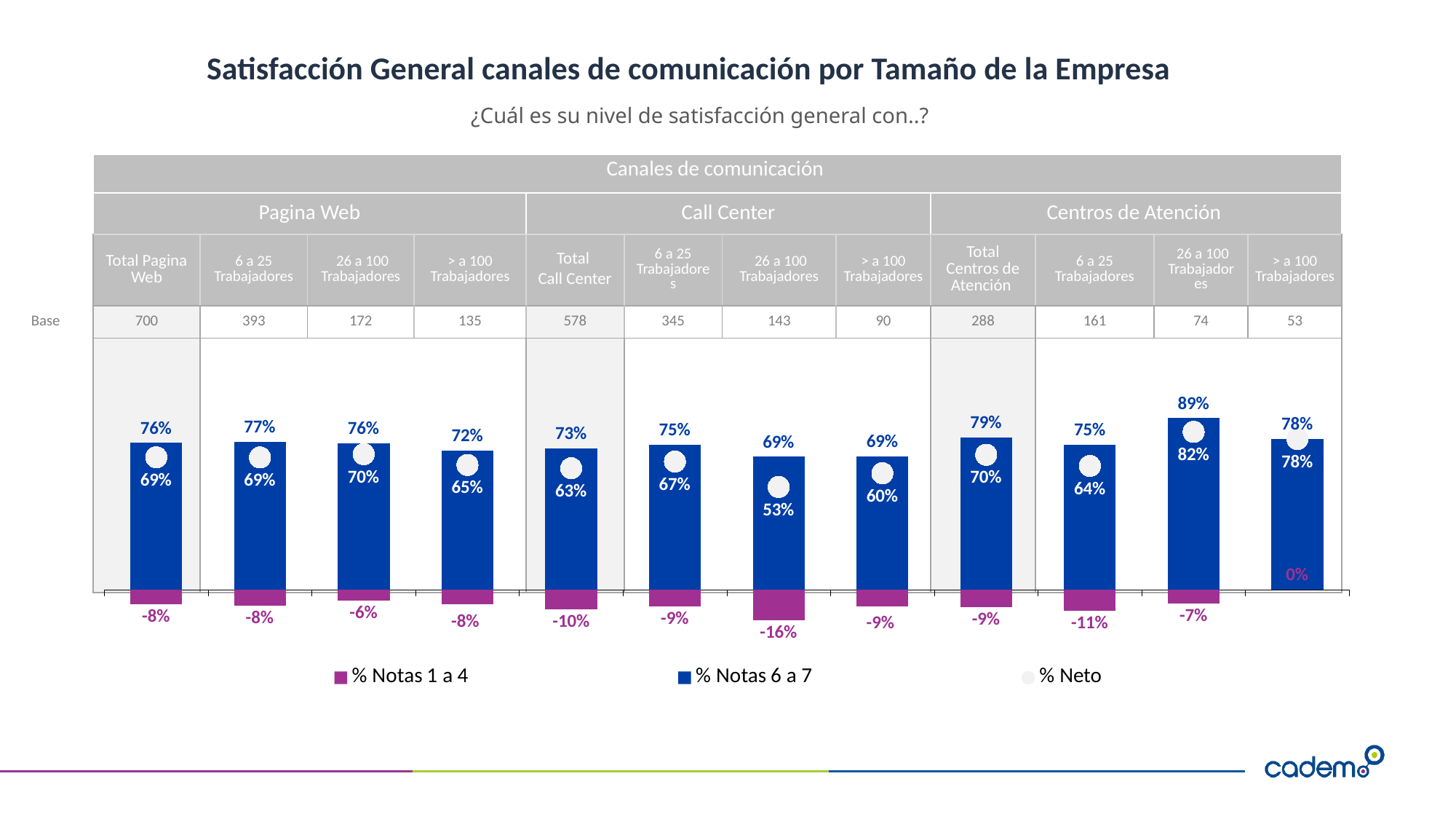
How many series does the legend list? 3 Which is larger, the % Neto for Total Pagina Web or the % Neto for Total Call Center? Total Pagina Web Which category has the lowest % Neto value? 26 a 100 Trabajadores (Call Center) Which category has the highest % Notas 6 a 7 value? 26 a 100 Trabajadores (Centros de Atención) What kind of chart is shown on the slide? Bar chart How many categories are plotted on the chart? 12 What is the % Neto value for 26 a 100 Trabajadores under Call Center? 53% What is the % Notas 1 a 4 value for Total Call Center? -10% What is the % Notas 6 a 7 value for Total Pagina Web? 76% Which category has a % Notas 1 a 4 value of 0%? > a 100 Trabajadores (Centros de Atención) What is the difference between the % Notas 6 a 7 values for Total Centros de Atención and Total Call Center? 6% What is the base (sample size) for Total Centros de Atención? 288